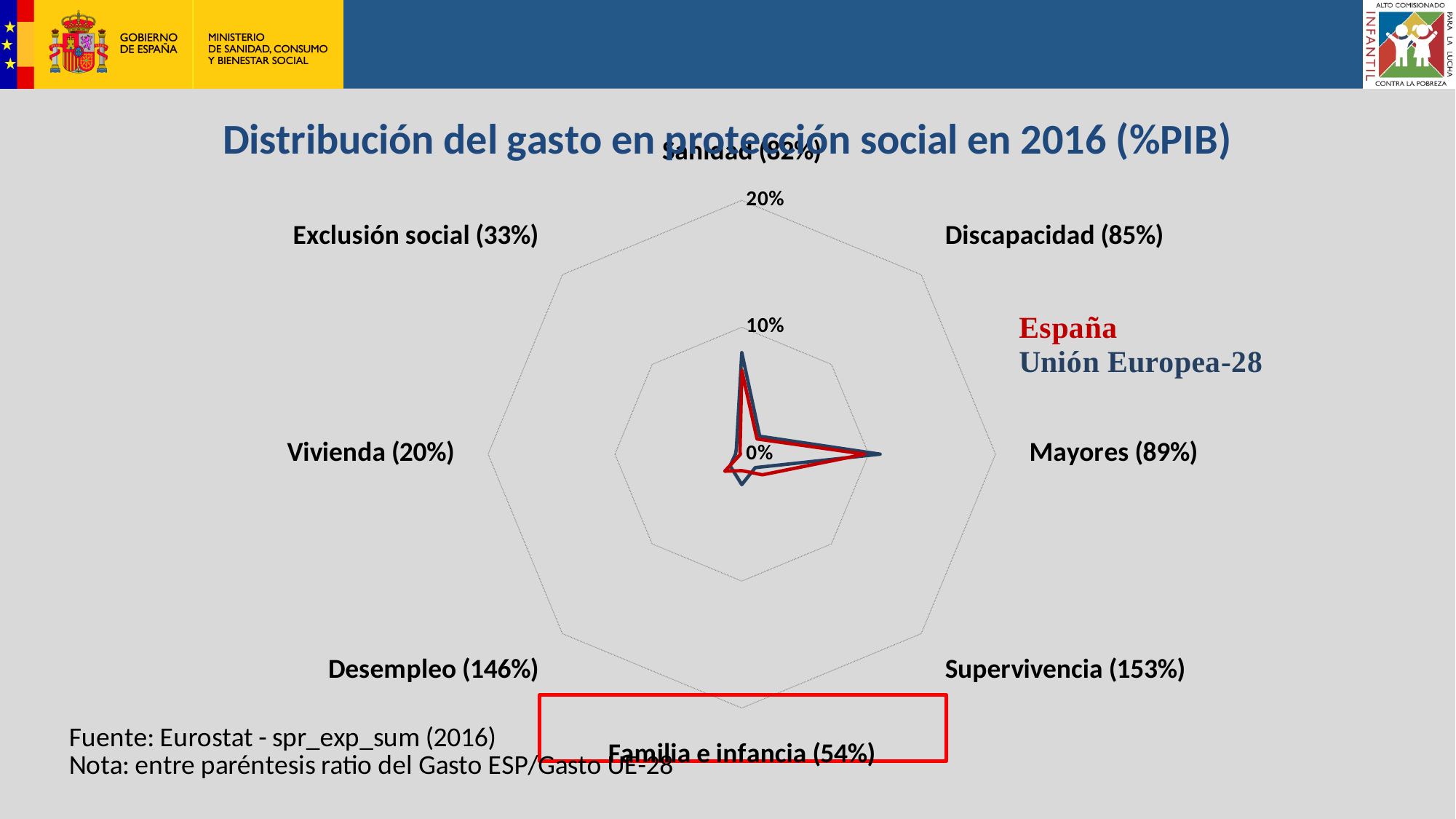
What ratio is shown in parentheses for Supervivencia? 153% Which category has the highest value for España? Mayores Is the value for Vivienda for España greater or less than 10%? less Which category has the highest value for Unión Europea-28? Mayores What ratio of Spanish to EU-28 spending is shown in parentheses for Desempleo? 146% Is the value for Sanidad for Unión Europea-28 greater or less than 10%? less How many series does the chart legend list? 2 Which colour represents España in the chart? Red For España, which is larger: the value for Mayores or the value for Sanidad? Mayores What kind of chart is shown on the slide? Radar chart How many categories (axes) does the radar chart have? 8